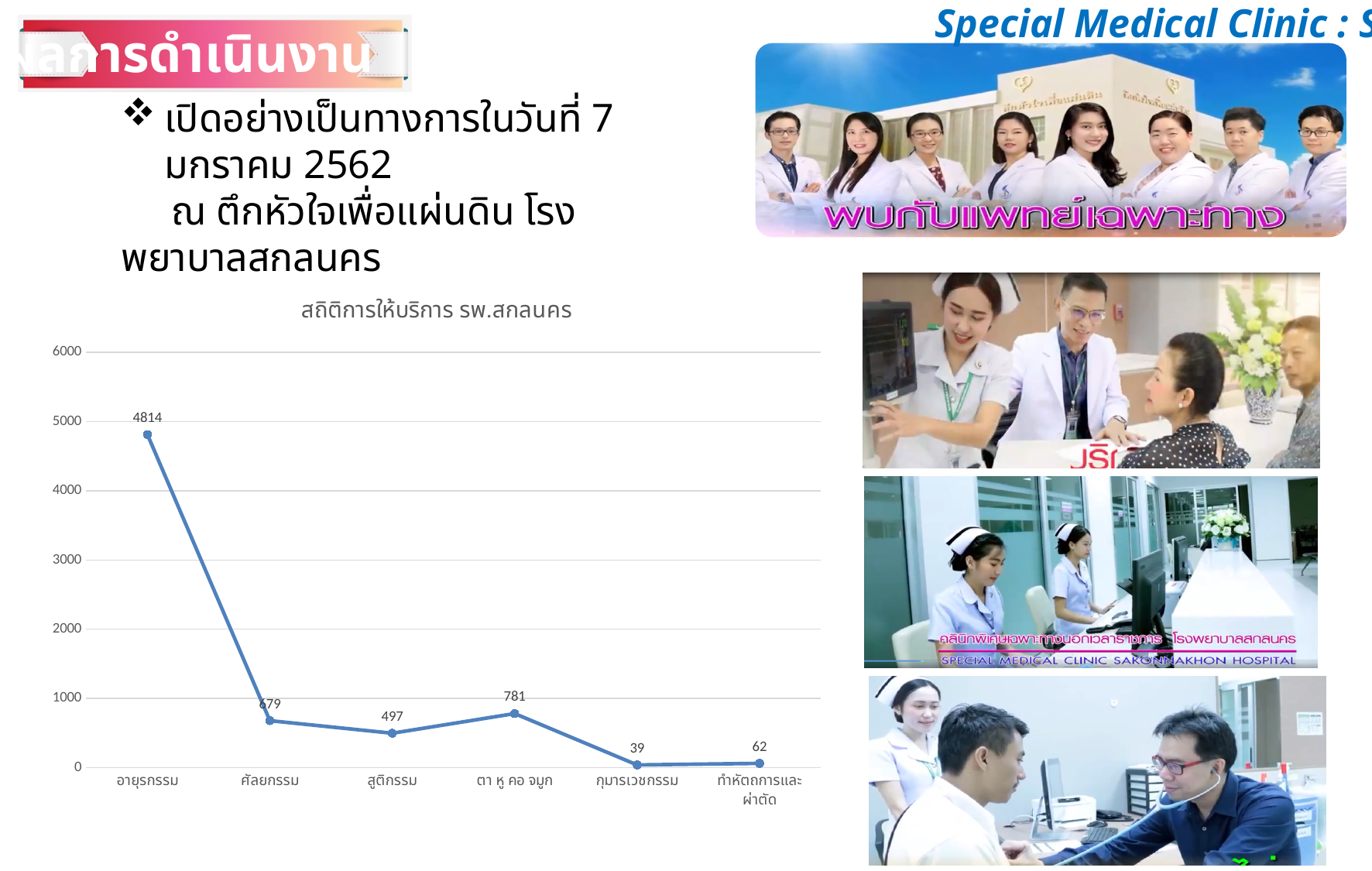
What is the difference between the values for ตา หู คอ จมูก and สูติกรรม? 284 What is the title of the chart on the slide? สถิติการให้บริการ รพ.สกลนคร What is the value for อายุรกรรม in the chart สถิติการให้บริการ รพ.สกลนคร? 4814 What is the value for ตา หู คอ จมูก in the chart? 781 What is the value for กุมารเวชกรรม in the chart? 39 Which is larger, the value for ทำหัตถการและผ่าตัด or the value for กุมารเวชกรรม? ทำหัตถการและผ่าตัด Which category has the lowest value in the chart? กุมารเวชกรรม What kind of chart is shown on the slide? line chart How many categories are plotted on the x axis of the chart? 6 Which category has the highest value in the chart? อายุรกรรม What is the difference between the values for อายุรกรรม and ศัลยกรรม? 4135 What is the value for ศัลยกรรม in the chart? 679